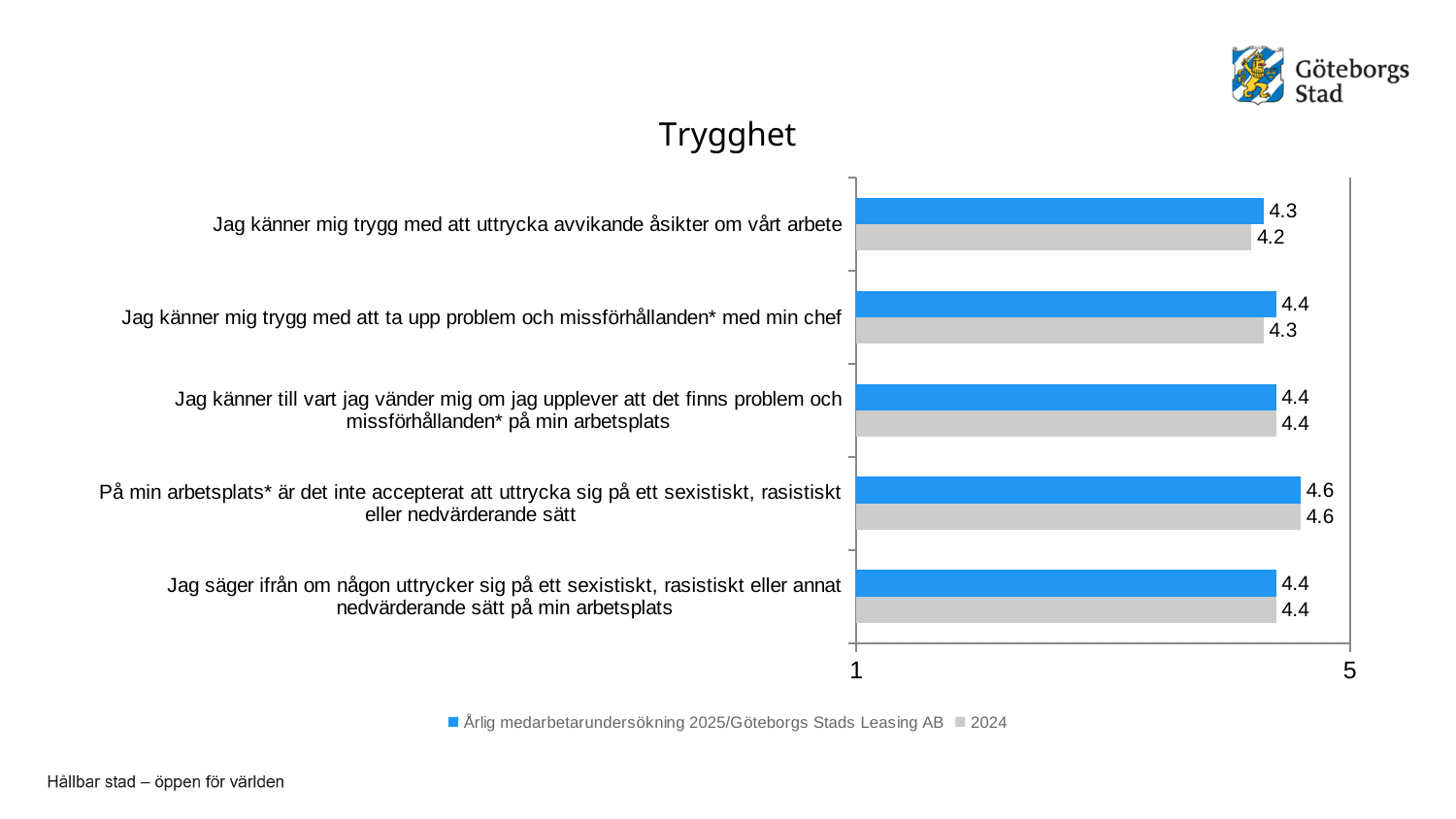
How many series does the legend list? 2 For "Jag känner mig trygg med att ta upp problem och missförhållanden* med min chef", which is larger: the 2025 value or the 2024 value? 2025 What is the 2024 value for "Jag säger ifrån om någon uttrycker sig på ett sexistiskt, rasistiskt eller annat nedvärderande sätt på min arbetsplats"? 4.4 What is the 2024 value for "Jag känner mig trygg med att ta upp problem och missförhållanden* med min chef"? 4.3 What kind of chart is shown on the slide? Bar chart What is the 2025 value for "På min arbetsplats* är det inte accepterat att uttrycka sig på ett sexistiskt, rasistiskt eller nedvärderande sätt"? 4.6 What is the title of the chart? Trygghet How many statements (categories) are shown in the chart? 5 Which statement has the highest 2025 value? På min arbetsplats* är det inte accepterat att uttrycka sig på ett sexistiskt, rasistiskt eller nedvärderande sätt What is the 2025 value for "Jag känner mig trygg med att uttrycka avvikande åsikter om vårt arbete"? 4.3 Which statement has the lowest 2024 value? Jag känner mig trygg med att uttrycka avvikande åsikter om vårt arbete What is the difference between the 2025 and 2024 values for "Jag känner mig trygg med att uttrycka avvikande åsikter om vårt arbete"? 0.1